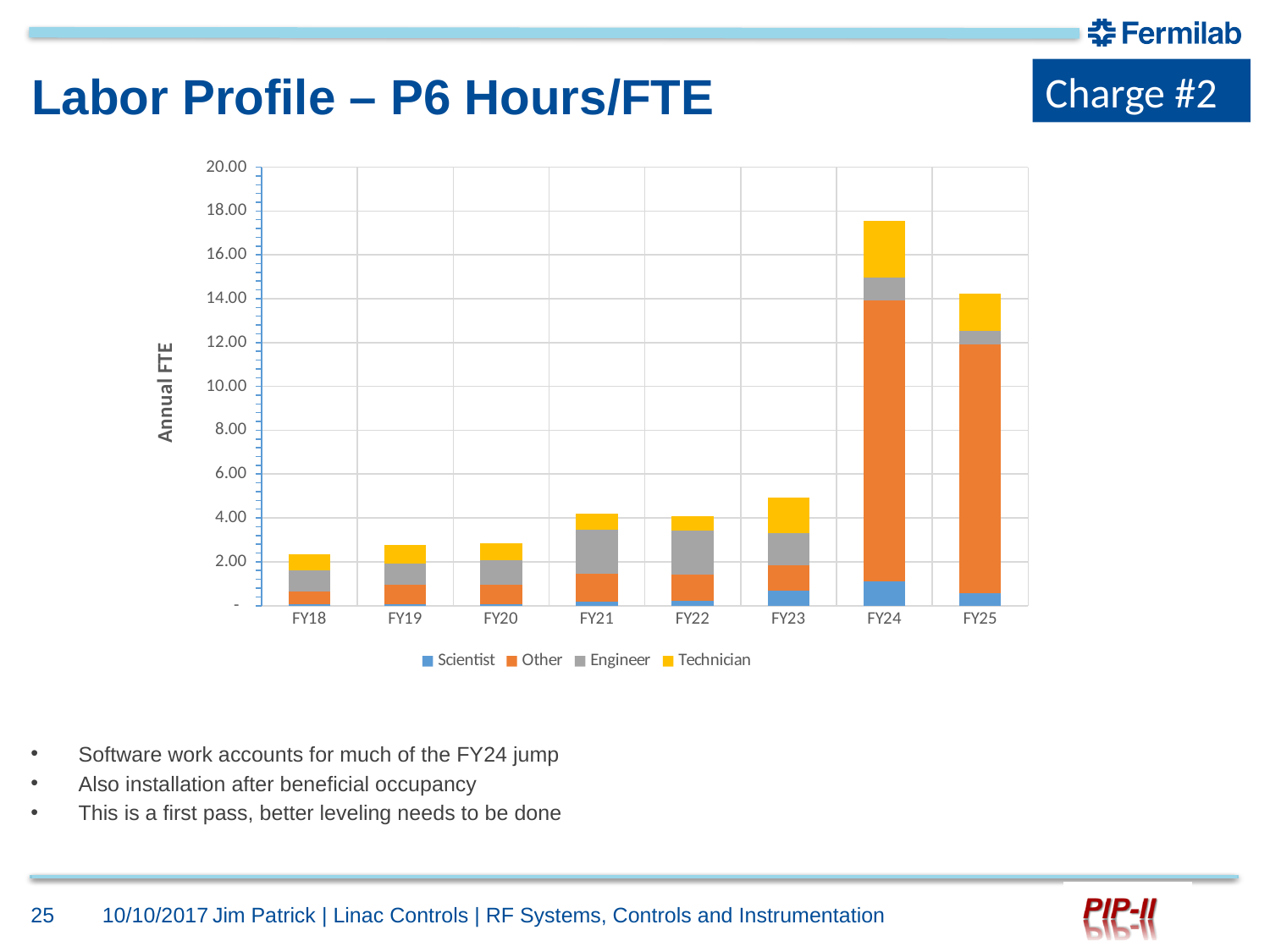
Is the total Annual FTE for FY24 greater or less than 16.00? greater How many series does the chart legend list? 4 Which series makes up the largest part of the FY24 bar? Other Which has the larger total Annual FTE, FY24 or FY25? FY24 Is the total Annual FTE for FY25 greater or less than 12.00? greater Does the total Annual FTE rise or fall from FY23 to FY24? Rise Is the total Annual FTE for FY18 greater or less than 4.00? less What kind of chart is shown on the slide? Stacked bar chart What is the title of the chart's vertical axis? Annual FTE How many fiscal years are shown on the x axis of the chart? 8 Which fiscal year has the highest total Annual FTE? FY24 Which fiscal year has the lowest total Annual FTE? FY18